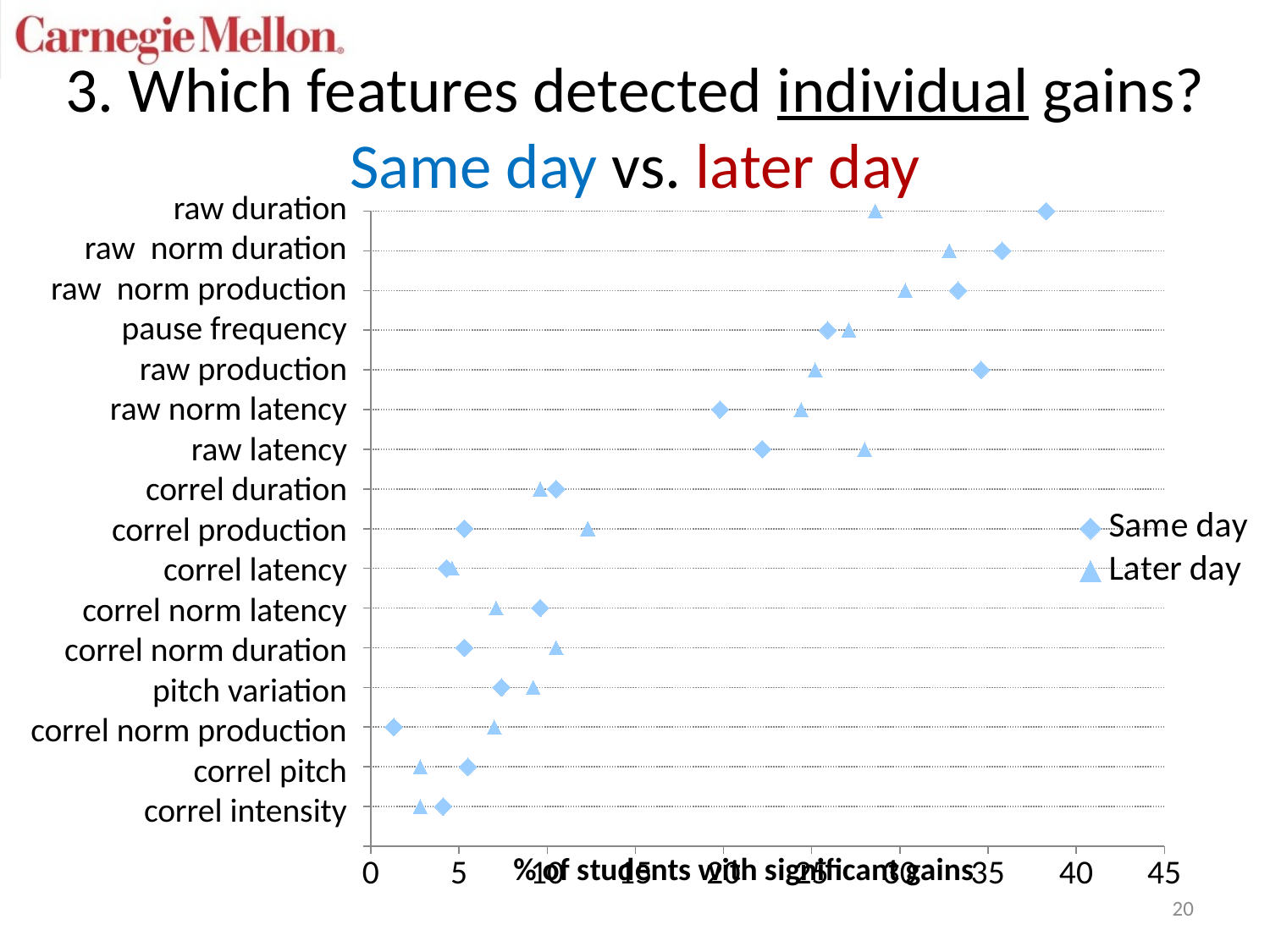
Which feature has the lowest Same day value? correl norm production Which feature has the highest Same day value? raw duration Is the Later day value for raw duration greater or less than 30? less Which feature has the highest Later day value? raw norm duration For raw production, which series has the larger value, Same day or Later day? Same day What kind of chart is shown on the slide? scatter chart Is the Same day value for raw duration greater or less than 35? greater For correl production, which series has the larger value, Same day or Later day? Later day How many feature categories are listed on the vertical axis? 16 What is the title of the horizontal axis? % of students with significant gains How many series does the legend list? 2 Is the Same day value for correl norm production greater or less than 5? less